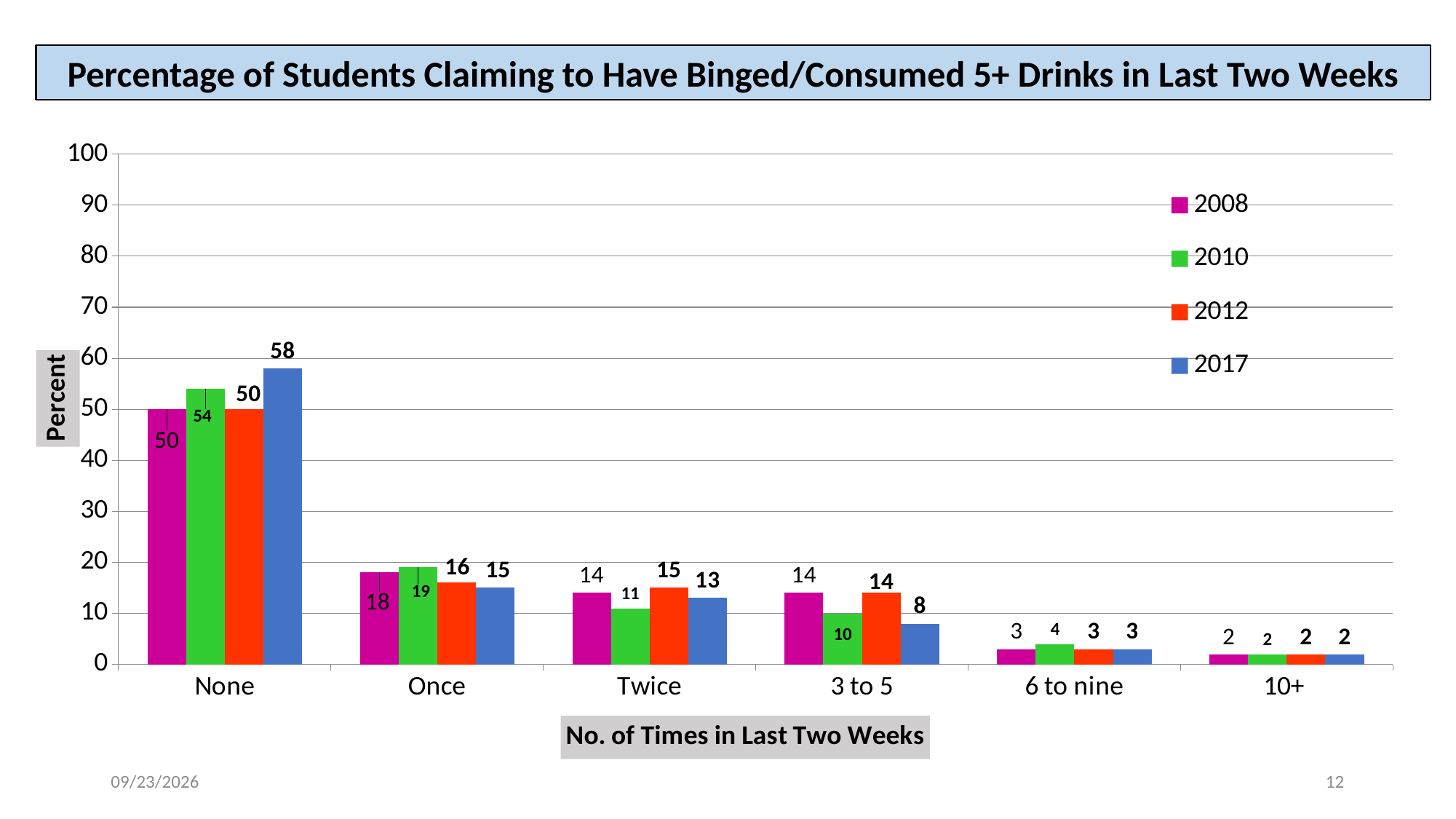
What is the value for 2017 in the None category? 58 Which year has the lowest value in the 3 to 5 category? 2017 How many categories are shown on the x axis? 6 What is the value for 2012 in the Twice category? 15 What is the label of the y axis? Percent Which is larger in the Twice category, the 2008 value or the 2010 value? 2008 What is the value for 2010 in the Once category? 19 What is the difference between the 2017 and 2008 values in the None category? 8 Which year has the highest value in the None category? 2017 How many series does the legend list? 4 What is the value for 2017 in the 3 to 5 category? 8 What kind of chart is shown on the slide? bar chart